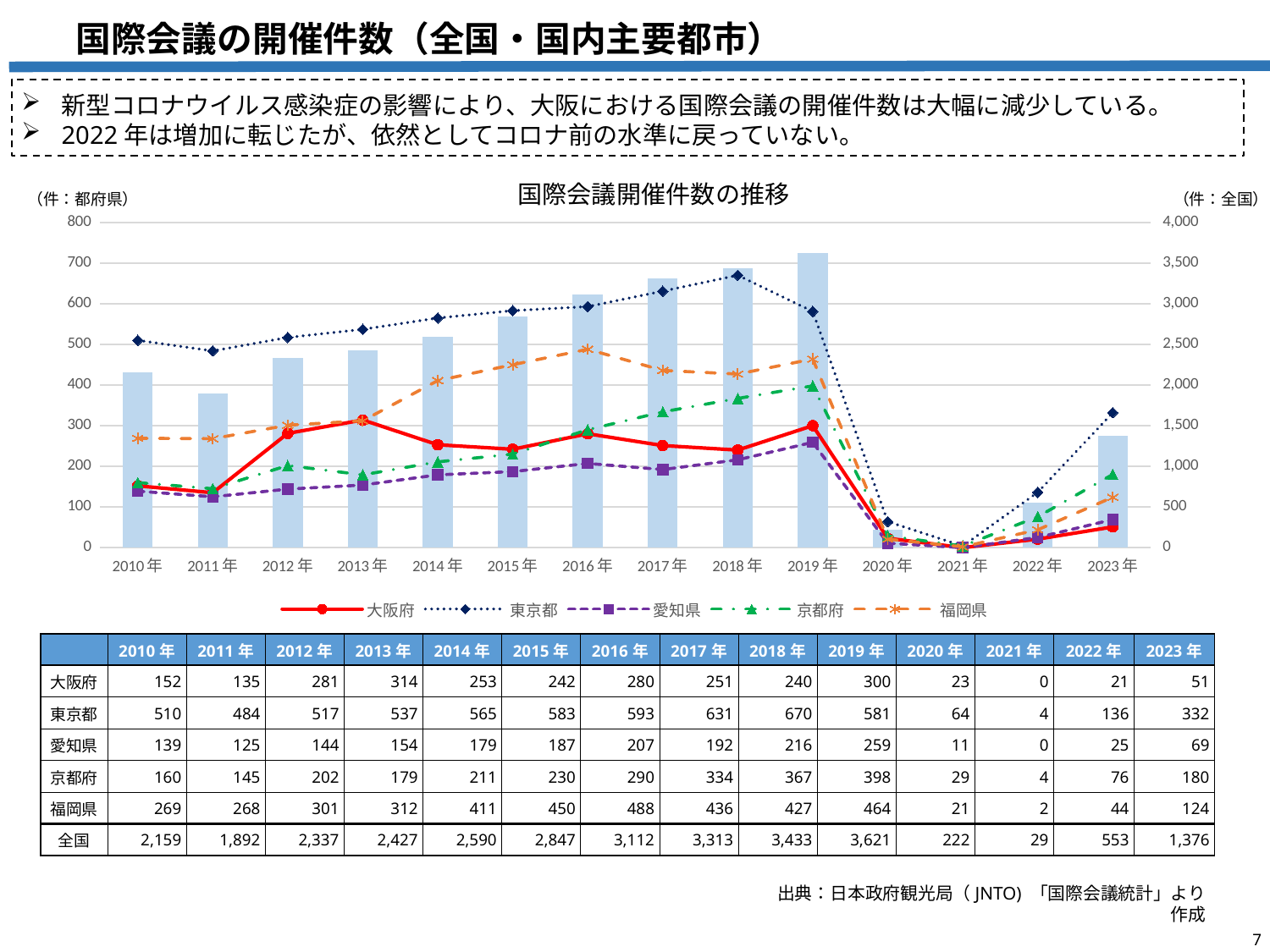
Which had more international conferences in 2016年, 福岡県 or 京都府? 福岡県 What was the number of international conferences held in 東京都 in 2018年? 670 What is the difference between the 大阪府 values for 2019年 and 2020年? 277 What was the nationwide (全国) number of international conferences in 2023年? 1,376 What was the number of international conferences held in 大阪府 in 2019年? 300 In which year did 東京都 record its highest number of international conferences? 2018年 How many series does the chart legend list? 5 How many years are shown on the x axis of the chart? 14 Did the 東京都 value rise or fall from 2021年 to 2023年? rise Is the 全国 value for 2019年 greater or less than 3,500? greater What is the title of the chart? 国際会議開催件数の推移 In which year did 全国 record its lowest number of international conferences? 2021年